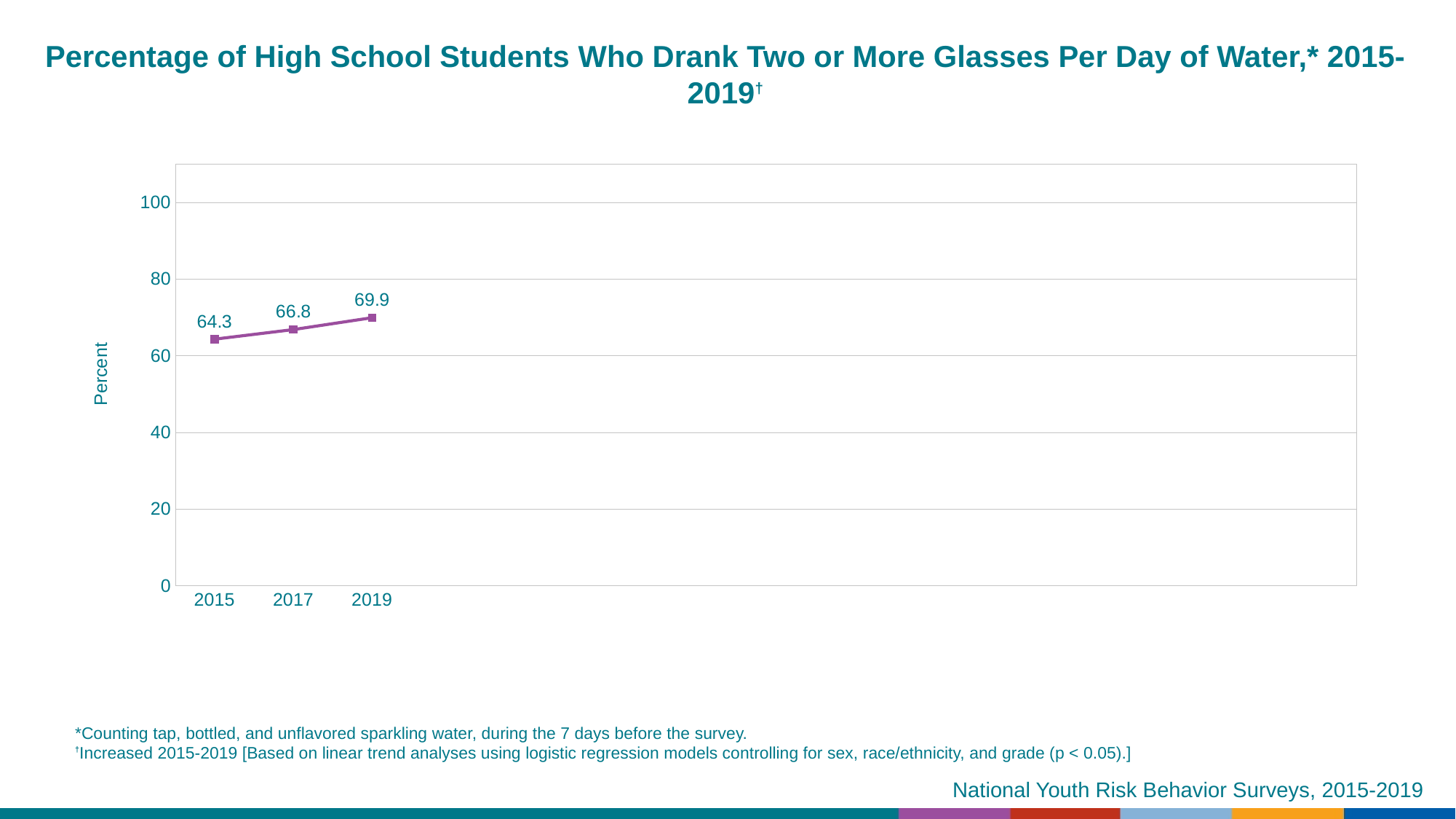
Is the value for 2019 greater or less than 80? less By how many percentage points did the value change from 2015 to 2019? 5.6 What percentage of high school students drank two or more glasses of water per day in 2017? 66.8 What percentage of high school students drank two or more glasses of water per day in 2015? 64.3 What kind of chart is shown on the slide? line chart What percentage of high school students drank two or more glasses of water per day in 2019? 69.9 Do the values rise or fall from 2015 to 2019? rise Which year has the highest percentage of students who drank two or more glasses of water per day? 2019 How many years are plotted on the chart? 3 Is the value for 2017 greater or less than the value for 2015? greater What is the difference between the 2017 and 2015 values? 2.5 Which year has the lowest percentage of students who drank two or more glasses of water per day? 2015